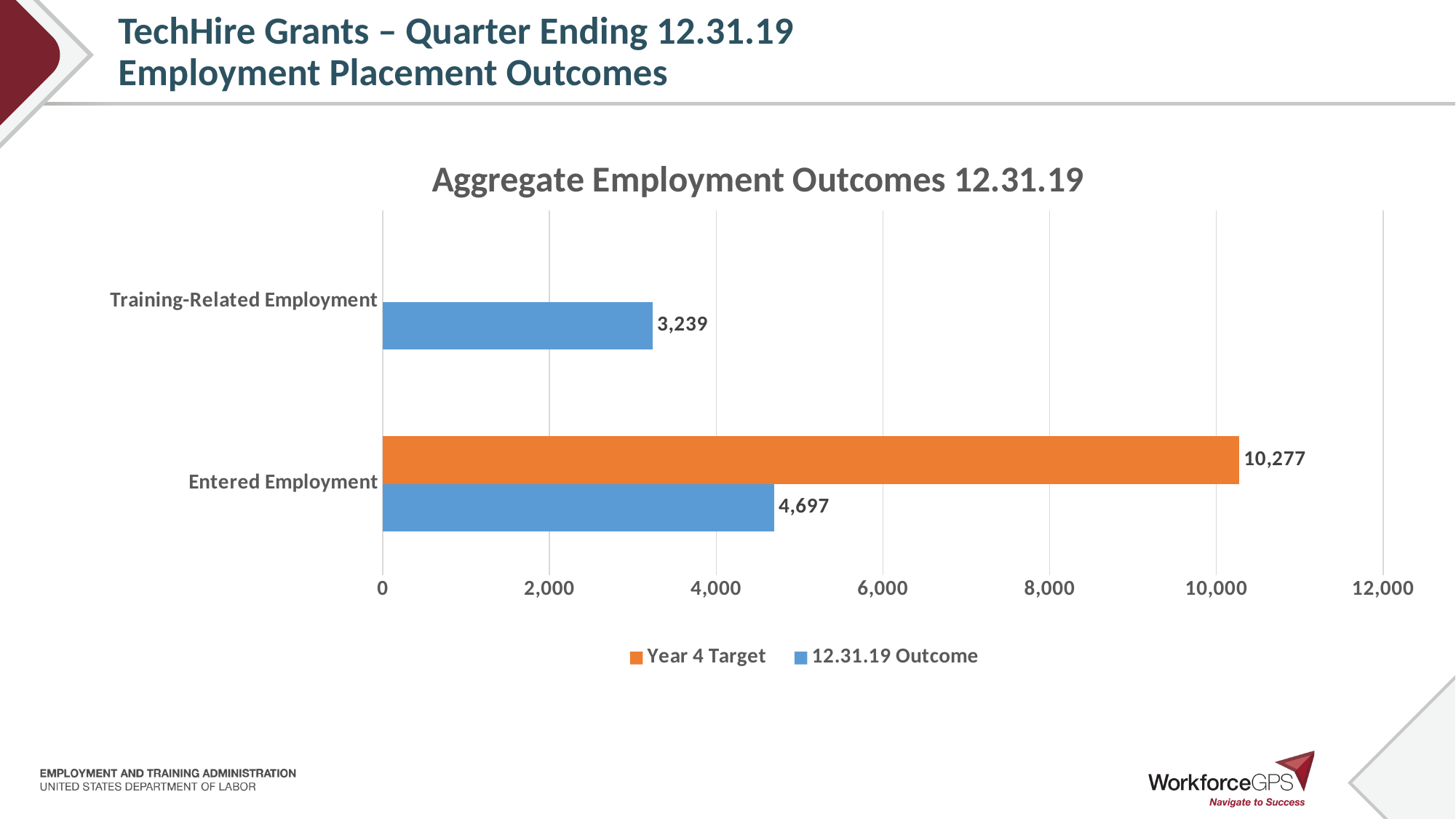
What is the difference between the 12.31.19 Outcome for Entered Employment and for Training-Related Employment? 1,458 What is the Year 4 Target value for Entered Employment? 10,277 What kind of chart is shown on the slide? Bar chart What is the title of the chart? Aggregate Employment Outcomes 12.31.19 What is the 12.31.19 Outcome value for Entered Employment? 4,697 How many categories are shown on the chart? 2 What is the 12.31.19 Outcome value for Training-Related Employment? 3,239 What is the difference between the Year 4 Target and the 12.31.19 Outcome for Entered Employment? 5,580 Is the Year 4 Target for Entered Employment greater or less than 10,000? greater How many series does the legend list? 2 Which category has the higher 12.31.19 Outcome value? Entered Employment Which is larger for Entered Employment: the Year 4 Target or the 12.31.19 Outcome? Year 4 Target